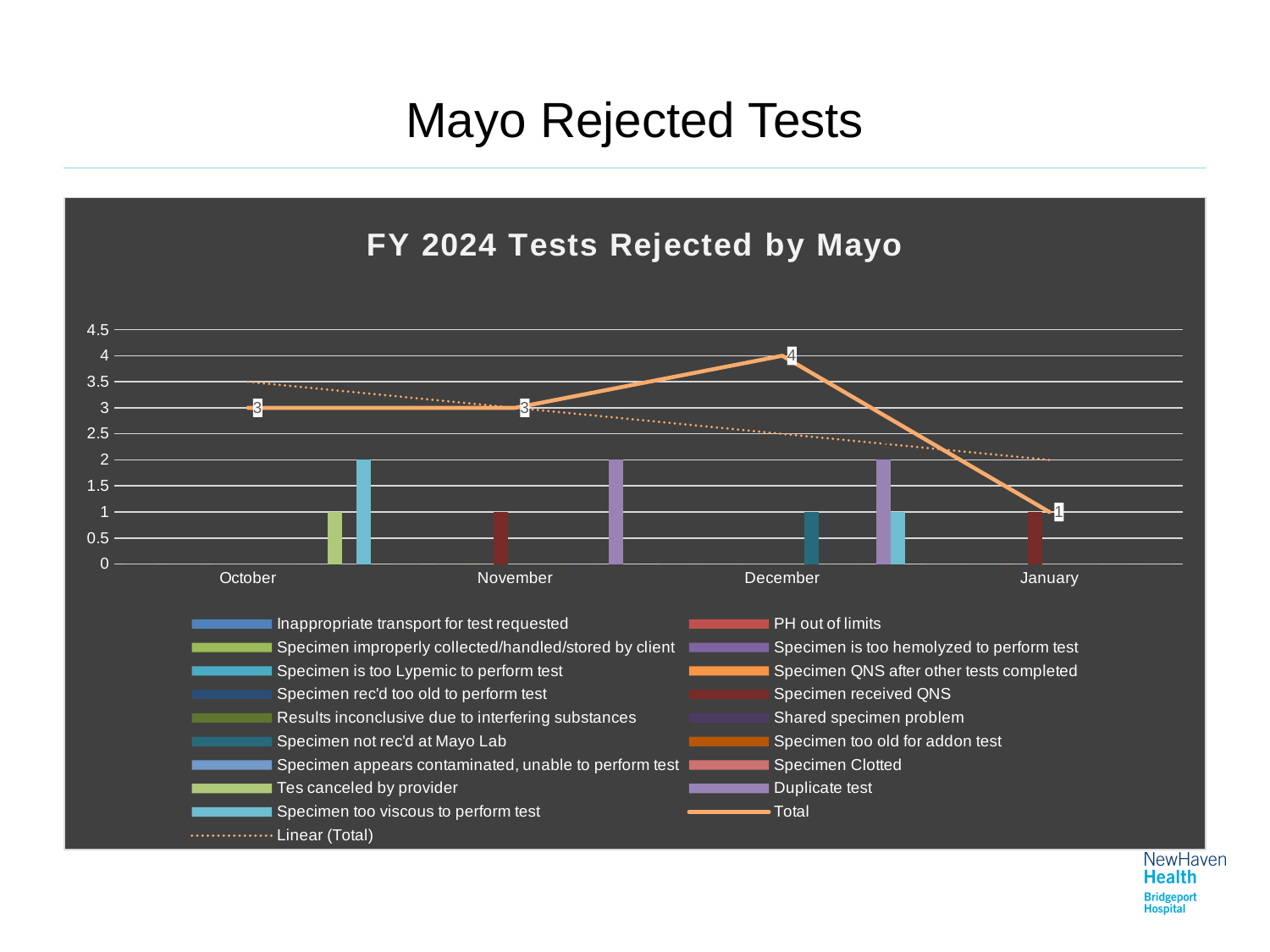
What is the title of the chart? FY 2024 Tests Rejected by Mayo In which month is the Total lowest? January How many months are shown on the x axis? 4 Does the Total rise or fall from December to January? fall Is the Total for December greater or less than 3.5? greater What is the Total value for December? 4 What is the difference between the Total for December and the Total for January? 3 What is the Total value for October? 3 How many bars are plotted for December? 3 What is the Total value for January? 1 Which month has a larger Total, October or January? October In which month is the Total highest? December